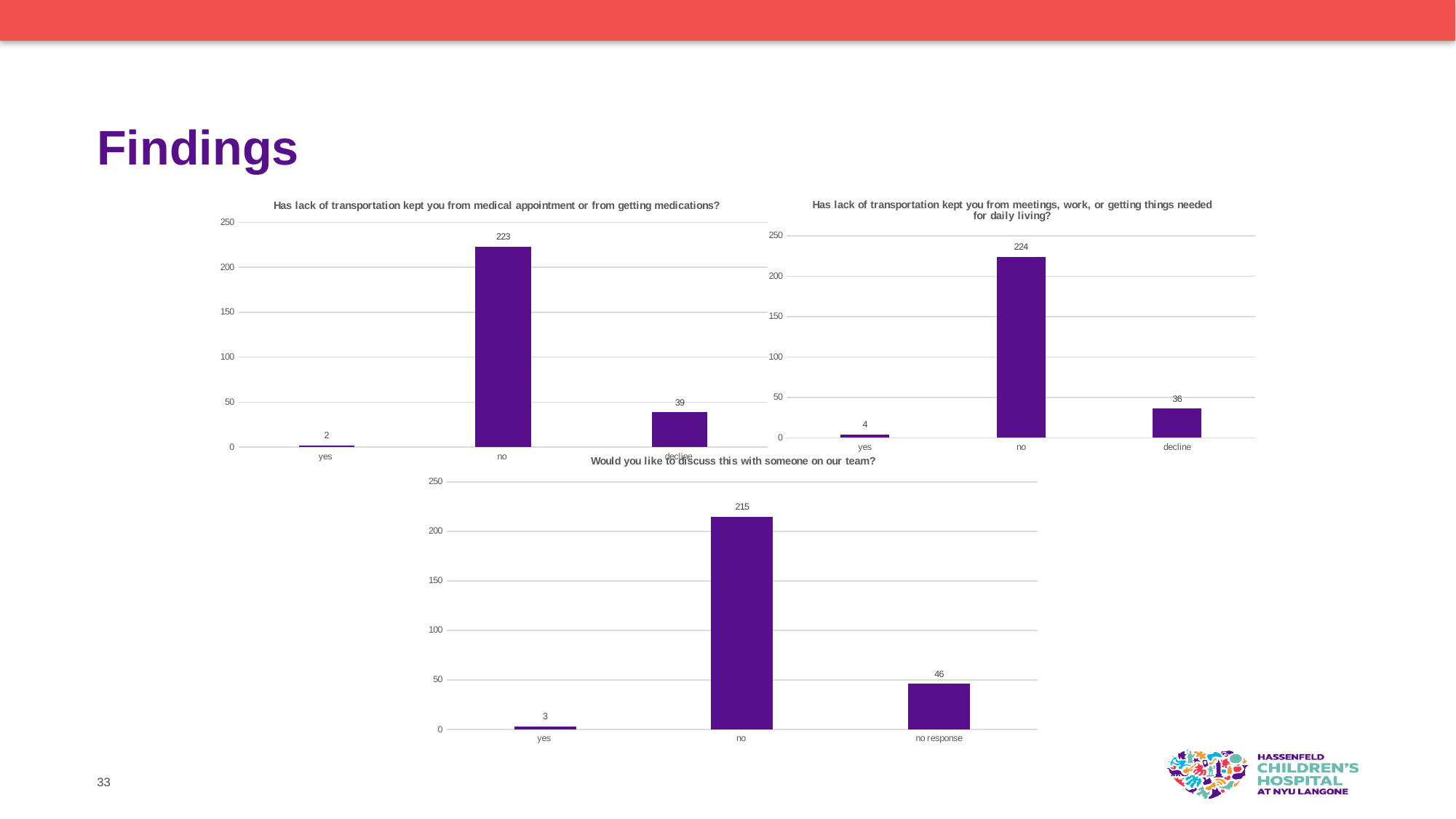
What type of chart is the chart titled "Has lack of transportation kept you from medical appointment or from getting medications?"? Bar chart In the chart titled "Has lack of transportation kept you from medical appointment or from getting medications?", what is the value for "no"? 223 In the chart titled "Has lack of transportation kept you from meetings, work, or getting things needed for daily living?", what is the value for "yes"? 4 In the chart titled "Would you like to discuss this with someone on our team?", what is the difference between the values for "no" and "no response"? 169 In the chart titled "Has lack of transportation kept you from meetings, work, or getting things needed for daily living?", which category has the highest value? no In the chart titled "Has lack of transportation kept you from medical appointment or from getting medications?", what is the difference between the values for "decline" and "yes"? 37 In the chart titled "Has lack of transportation kept you from meetings, work, or getting things needed for daily living?", is the value for "decline" greater or less than 50? less In the chart titled "Has lack of transportation kept you from medical appointment or from getting medications?", what is the value for "decline"? 39 Which is larger: the "no" value in the chart about medical appointments or the "no" value in the chart about meetings, work, or daily living? The chart about meetings, work, or daily living (224) In the chart titled "Would you like to discuss this with someone on our team?", what is the value for "no response"? 46 In the chart titled "Would you like to discuss this with someone on our team?", which category has the lowest value? yes How many categories are shown in the chart titled "Would you like to discuss this with someone on our team?"? 3